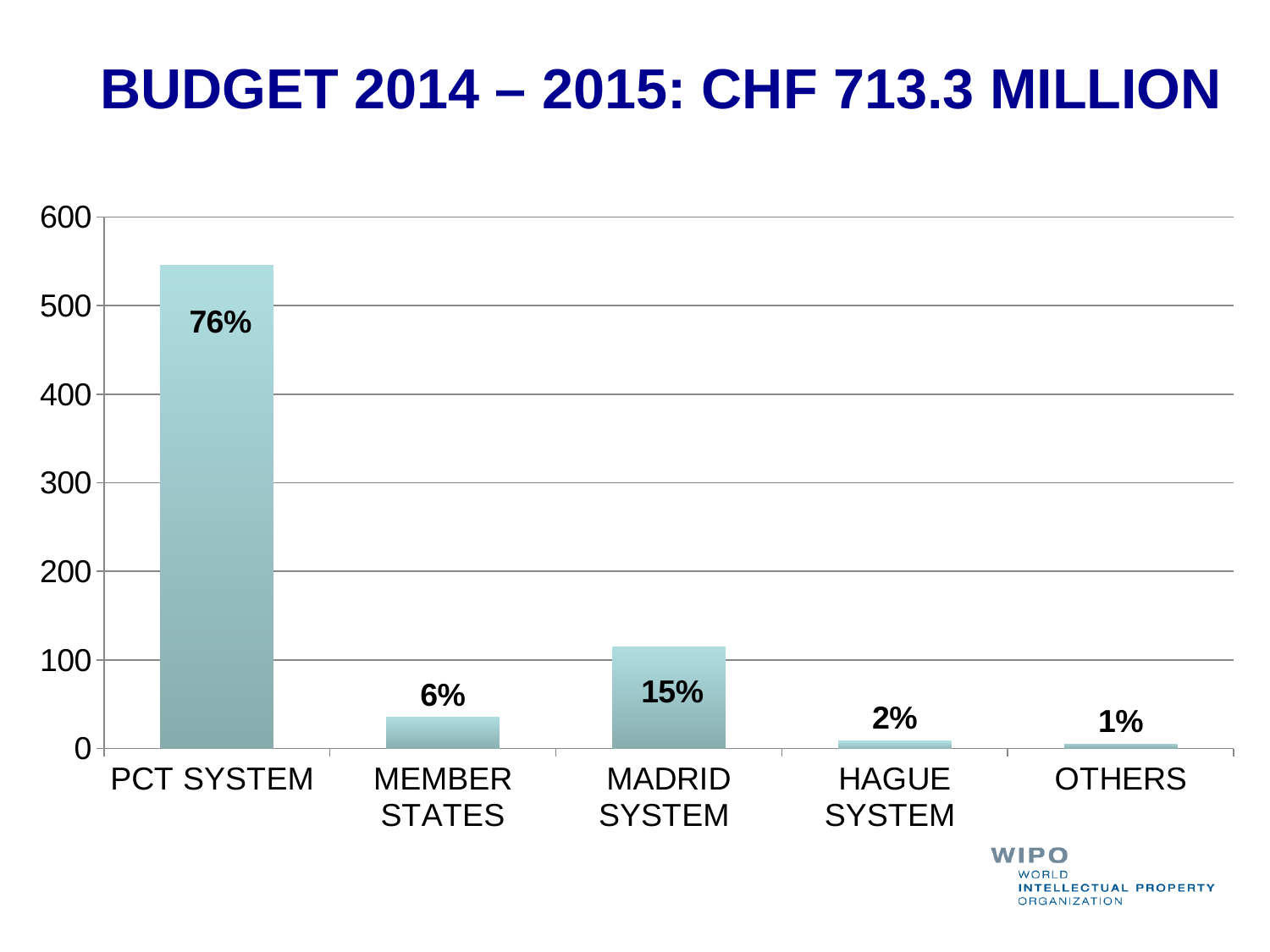
Which category has the lowest bar? OTHERS Is the value for PCT SYSTEM greater or less than 500? greater Is the value for MADRID SYSTEM greater or less than 100? greater What percentage label is shown on the MADRID SYSTEM bar? 15% What percentage label is shown on the OTHERS bar? 1% Which category has the highest bar? PCT SYSTEM What percentage label is shown on the MEMBER STATES bar? 6% How many categories are shown on the x axis? 5 What percentage label is shown on the PCT SYSTEM bar? 76% Which is larger, the value for MADRID SYSTEM or the value for MEMBER STATES? MADRID SYSTEM Is the value for MEMBER STATES greater or less than 100? less What percentage label is shown on the HAGUE SYSTEM bar? 2%